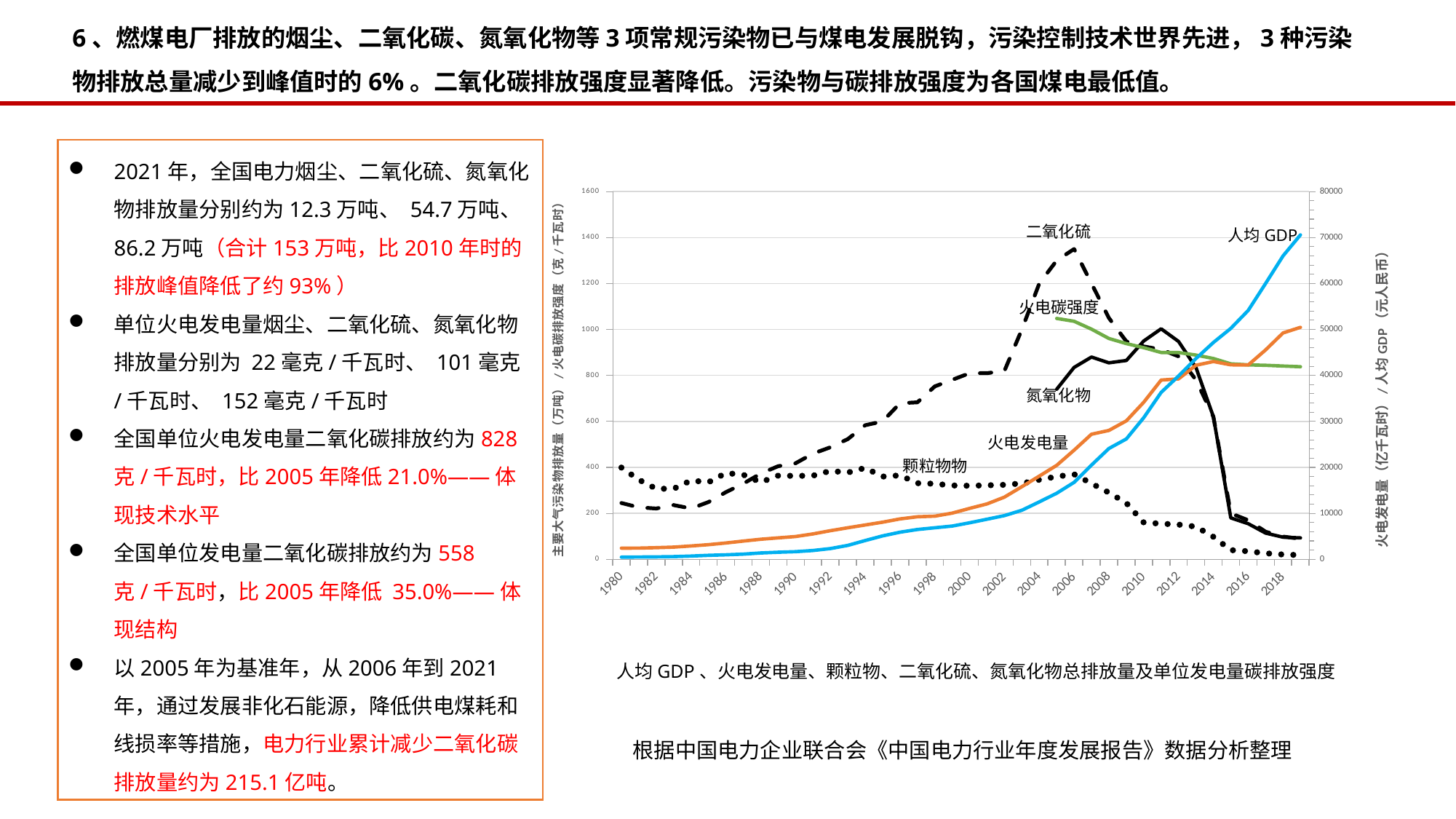
Which series reaches the highest value on the left axis around 2006? 二氧化硫 Is the value of 人均GDP in 2018 greater or less than 60000 on the right axis? greater Is the value of 火电发电量 in 2018 greater or less than 40000 on the right axis? greater Is the value of 颗粒物 in 2018 greater or less than 200 on the left axis? less In 2018, which is higher on the left axis: 氮氧化物 or 火电碳强度? 火电碳强度 How many year labels are shown along the x axis of the chart? 20 How many data series are labelled on the chart? 6 What is the caption printed below the chart? 人均GDP、火电发电量、颗粒物、二氧化硫、氮氧化物总排放量及单位发电量碳排放强度 Does the 人均GDP line rise or fall from 1980 to 2018? rise What kind of chart is shown on the right side of the slide? line chart